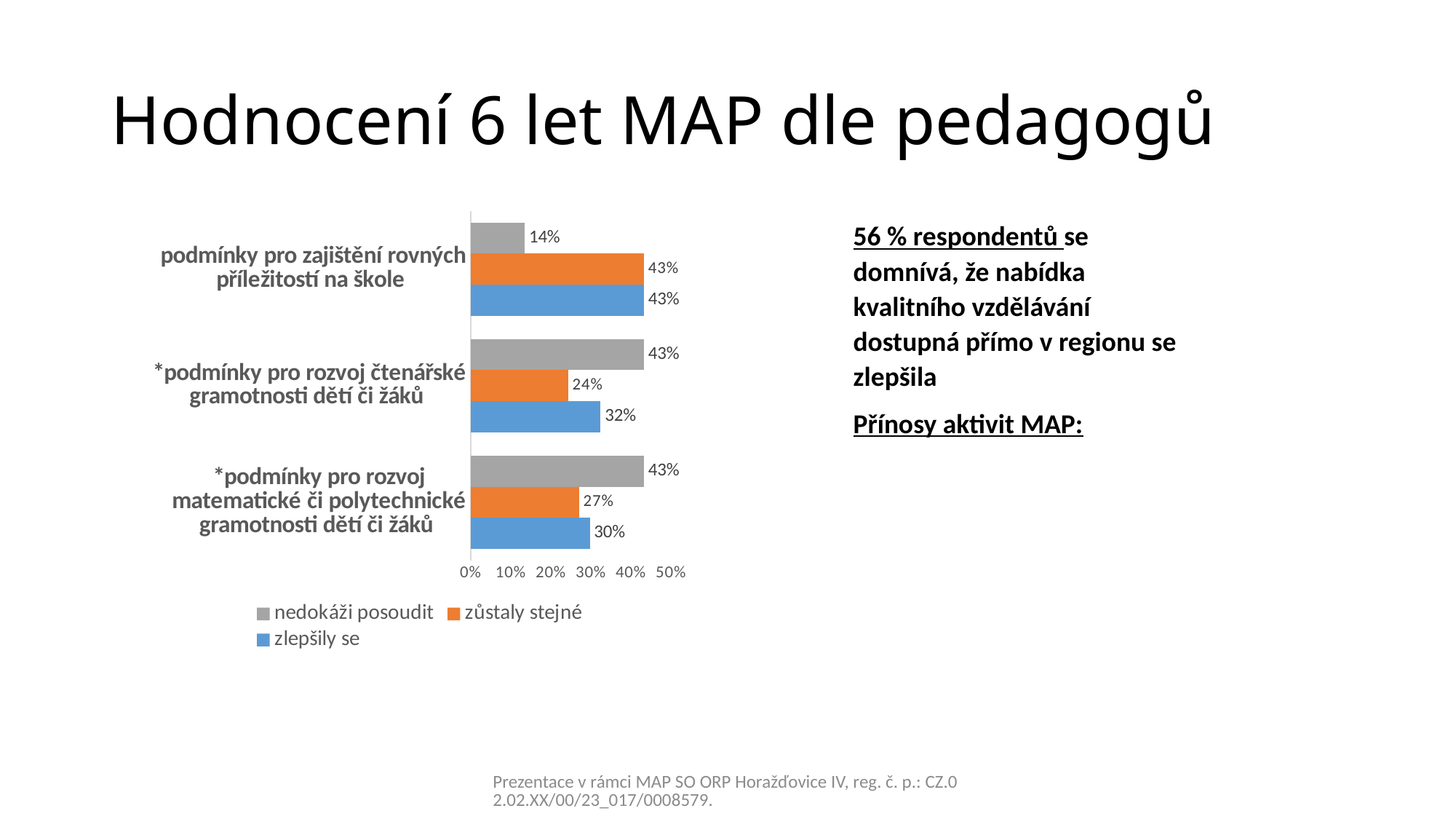
For "*podmínky pro rozvoj matematické či polytechnické gramotnosti dětí či žáků", which is larger: "zlepšily se" or "zůstaly stejné"? zlepšily se What is the value of "zlepšily se" for "podmínky pro zajištění rovných příležitostí na škole"? 43% What is the value of "zůstaly stejné" for "*podmínky pro rozvoj čtenářské gramotnosti dětí či žáků"? 24% How many categories are shown on the chart? 3 What is the value of "zlepšily se" for "*podmínky pro rozvoj matematické či polytechnické gramotnosti dětí či žáků"? 30% What is the difference between "zlepšily se" and "zůstaly stejné" for "*podmínky pro rozvoj čtenářské gramotnosti dětí či žáků"? 8% What kind of chart is shown on the slide? bar chart Which category has the lowest value for "nedokáži posoudit"? podmínky pro zajištění rovných příležitostí na škole Which series is shown in orange in the legend? zůstaly stejné How many series does the legend list? 3 Which category has the highest value for "zlepšily se"? podmínky pro zajištění rovných příležitostí na škole What is the value of "nedokáži posoudit" for "podmínky pro zajištění rovných příležitostí na škole"? 14%